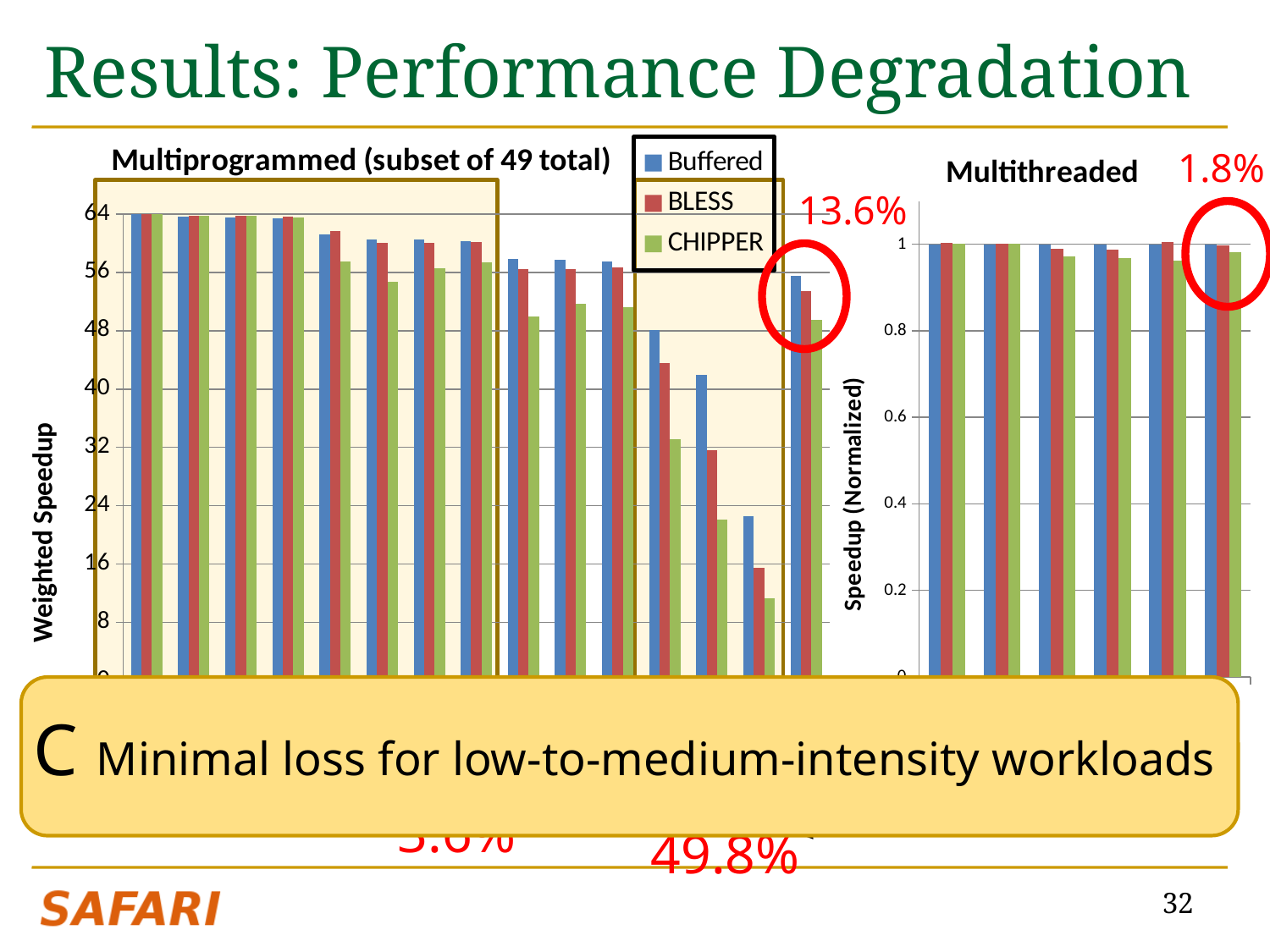
What kind of chart is the Multiprogrammed chart? bar chart What percentage is annotated next to the red circle on the Multiprogrammed chart? 13.6% Which series are listed in the legend? Buffered, BLESS, CHIPPER In the Multiprogrammed chart, do the Buffered values generally rise or fall from left to right along the x axis? fall What is the y-axis title of the Multiprogrammed chart? Weighted Speedup In the Multiprogrammed chart, is the Buffered value for the first (leftmost) group greater or less than 56? greater How many series does the legend list? 3 In the Multithreaded chart, is the Buffered value for the first group greater or less than 0.8? greater What percentage is annotated next to the red circle on the Multithreaded chart? 1.8% How many groups of bars are in the Multithreaded chart? 6 In the Multiprogrammed chart, which is larger: the Buffered value for the leftmost group or the Buffered value for the shortest group? the leftmost group In the Multiprogrammed chart, is the CHIPPER value for the second-to-last group (the shortest group) greater or less than 16? less